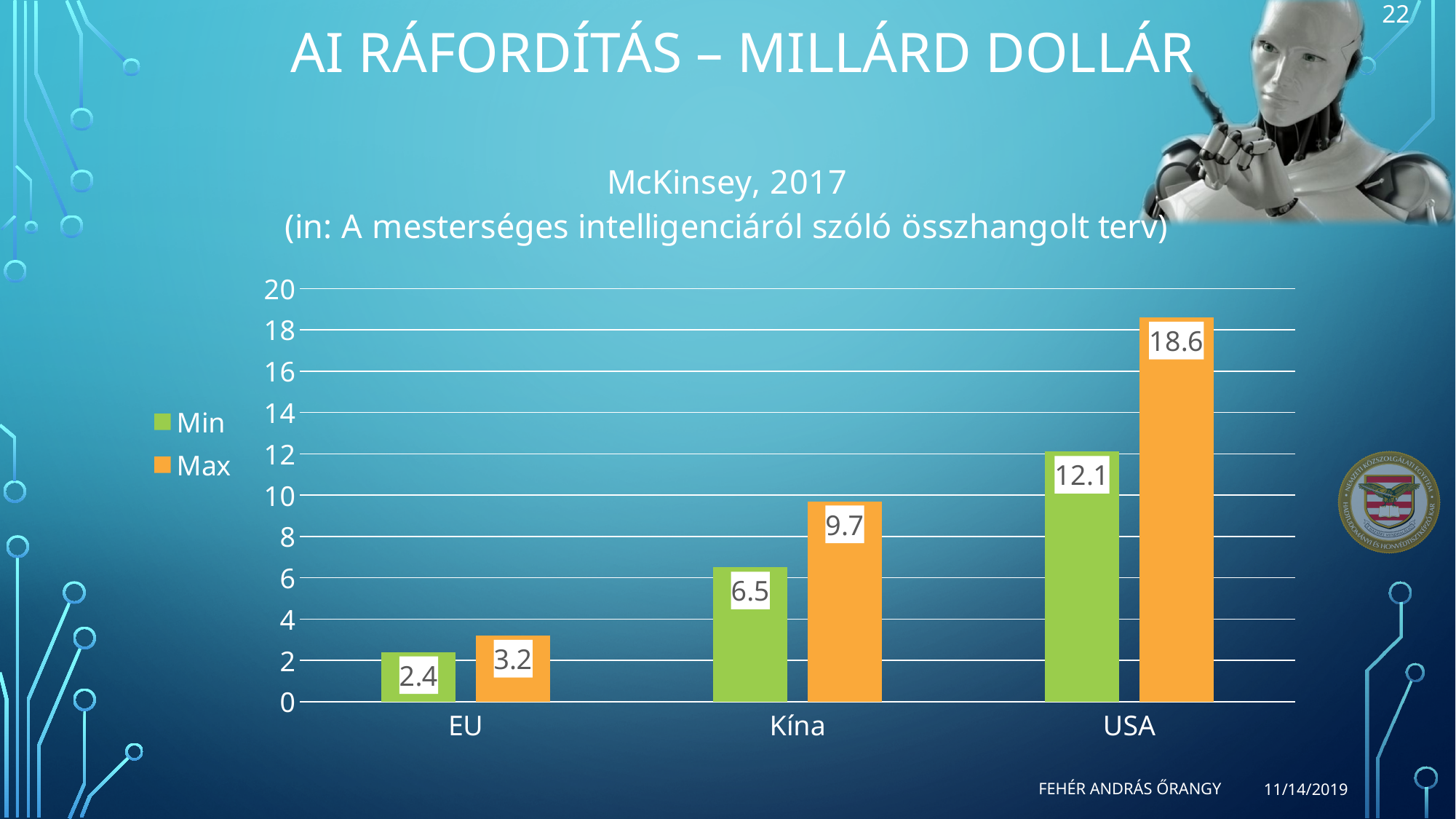
Is the Max value for Kína greater or less than 8? greater What kind of chart is shown on the slide? bar chart What is the difference between the Max values for Kína and EU? 6.5 How many categories are shown on the x axis? 3 Which category has the highest Max value? USA Which category has the lowest Min value? EU How many series does the legend list? 2 What is the difference between the Max and Min values for USA? 6.5 What is the Max value for USA? 18.6 What is the Min value for Kína? 6.5 What is the Max value for EU? 3.2 Which is larger, the Min value for USA or the Max value for Kína? Min value for USA